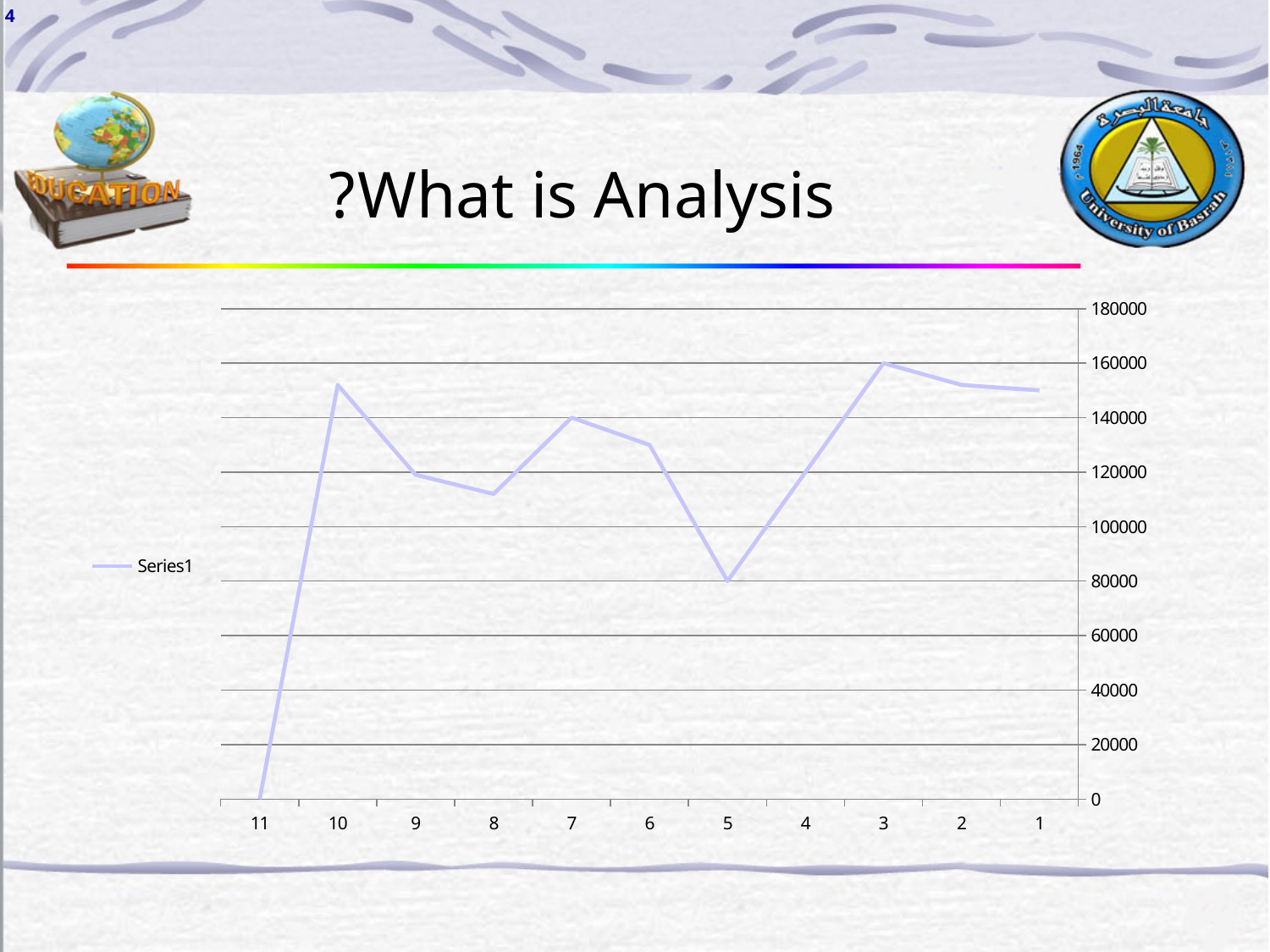
Which category has the highest value? 3 What kind of chart is shown on the slide? line chart How many categories are shown on the x axis? 11 Is the value for category 8 greater or less than 120000? less Which category has the lowest value? 11 What is the name of the series shown in the legend? Series1 Which is larger, the value for category 10 or the value for category 9? 10 Is the value for category 10 greater or less than 140000? greater How many series does the legend list? 1 What is the value for category 3? 160000 What is the value for category 5? 80000 Which is larger, the value for category 6 or the value for category 5? 6